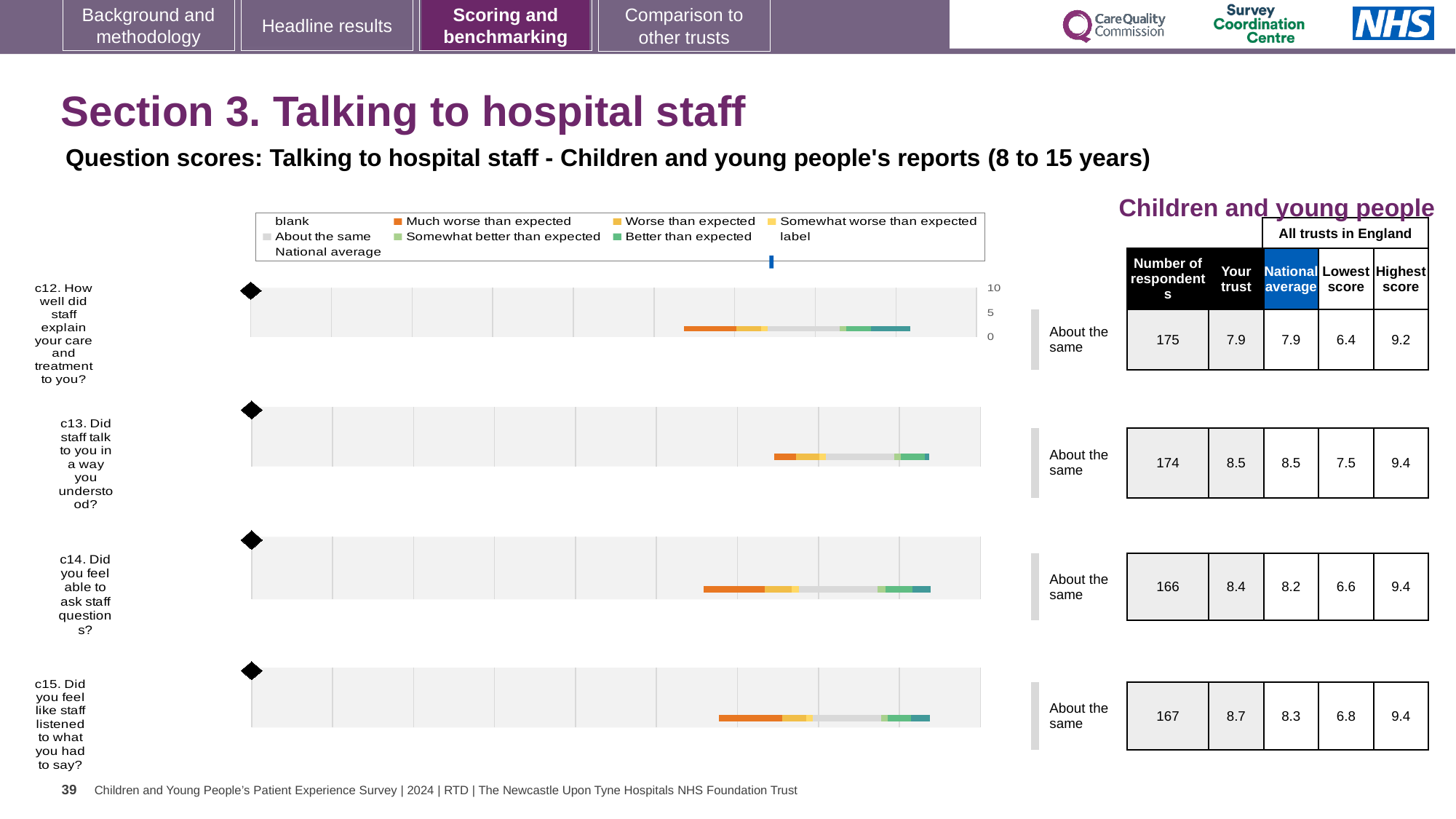
What benchmark label is shown next to the bar for c13? About the same What kind of chart is used to show the question scores on this slide? bar chart How many questions (c12 to c15) are plotted on the chart? 4 For c14, which is larger: the 'Your trust' score or the national average? Your trust How many respondents answered c15 (Did you feel like staff listened to what you had to say?)? 167 What is the highest score among all trusts in England for c12? 9.2 What is the national average score for c13 (Did staff talk to you in a way you understood?)? 8.5 What is the lowest score among all trusts in England for c14 (Did you feel able to ask staff questions?)? 6.6 Which question has the lowest 'Your trust' score? c12. How well did staff explain your care and treatment to you? What is the 'Your trust' score for c12 (How well did staff explain your care and treatment to you?)? 7.9 What is the difference between the 'Your trust' score and the national average for c15? 0.4 Which question has the highest 'Your trust' score? c15. Did you feel like staff listened to what you had to say?